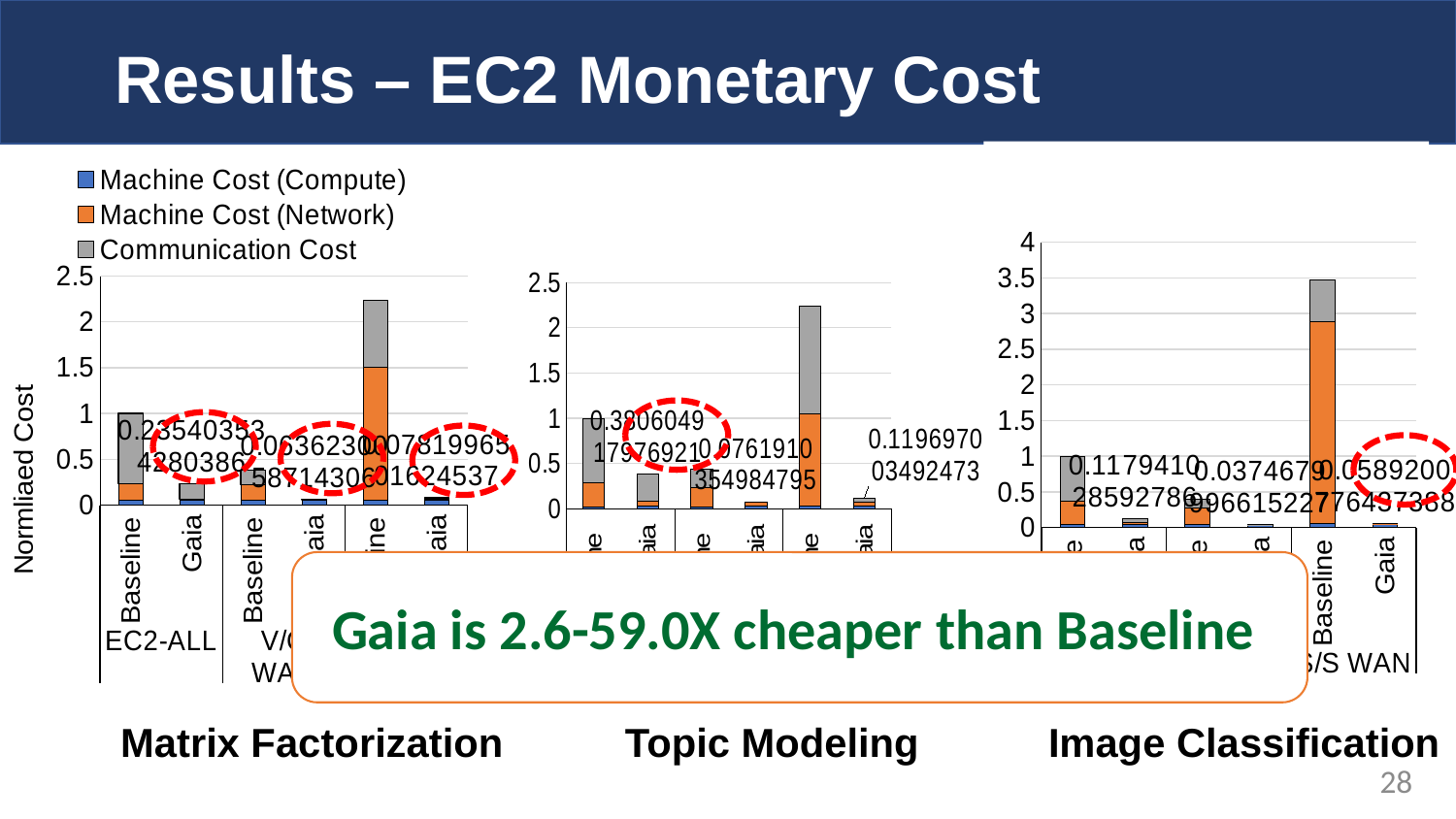
In the Image Classification chart, is the tallest bar greater or less than 3? greater In the Matrix Factorization chart, which is larger for EC2-ALL: the Baseline bar or the Gaia bar? Baseline In the Matrix Factorization chart, what is the total normalized cost of the Baseline bar for EC2-ALL? 1 In the Image Classification chart, is the tallest bar a Baseline bar or a Gaia bar? Baseline In the Image Classification chart, is the Gaia bar for EC2-ALL greater or less than 0.5? less What kind of chart is the Matrix Factorization chart? Stacked bar chart What does the callout box over the charts say? Gaia is 2.6-59.0X cheaper than Baseline How many series does the legend list for the charts on this slide? 3 In the Matrix Factorization chart, is the tallest bar greater or less than 2? greater What is the maximum value shown on the y axis of the Image Classification chart? 4 How many bars are plotted in the Topic Modeling chart? 6